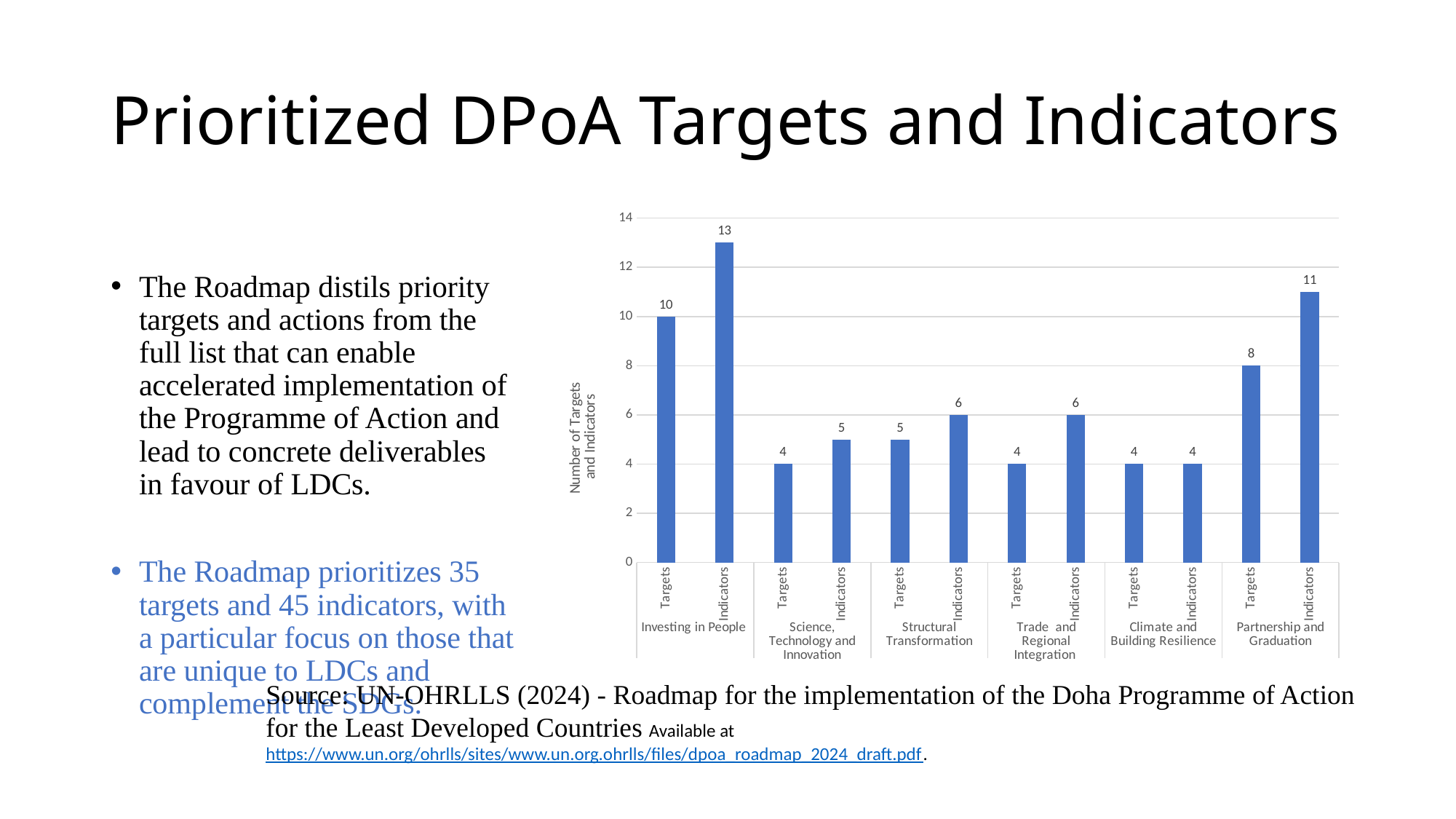
What is the label of the vertical axis of the chart? Number of Targets and Indicators How many bars are plotted in the chart? 12 How many focus areas are shown along the x axis of the chart? 6 How many Indicators are shown for Investing in People? 13 What is the difference between the Indicators and Targets values for Partnership and Graduation? 3 What kind of chart is shown on the slide? Bar chart How many Targets are shown for Partnership and Graduation? 8 What is the difference between the Targets values for Investing in People and Science, Technology and Innovation? 6 Which bar has the highest value in the chart? Investing in People Indicators How many Indicators are shown for Trade and Regional Integration? 6 Is the value for Investing in People Indicators greater or less than 12? greater Which is larger: the Targets value for Structural Transformation or the Targets value for Climate and Building Resilience? Structural Transformation